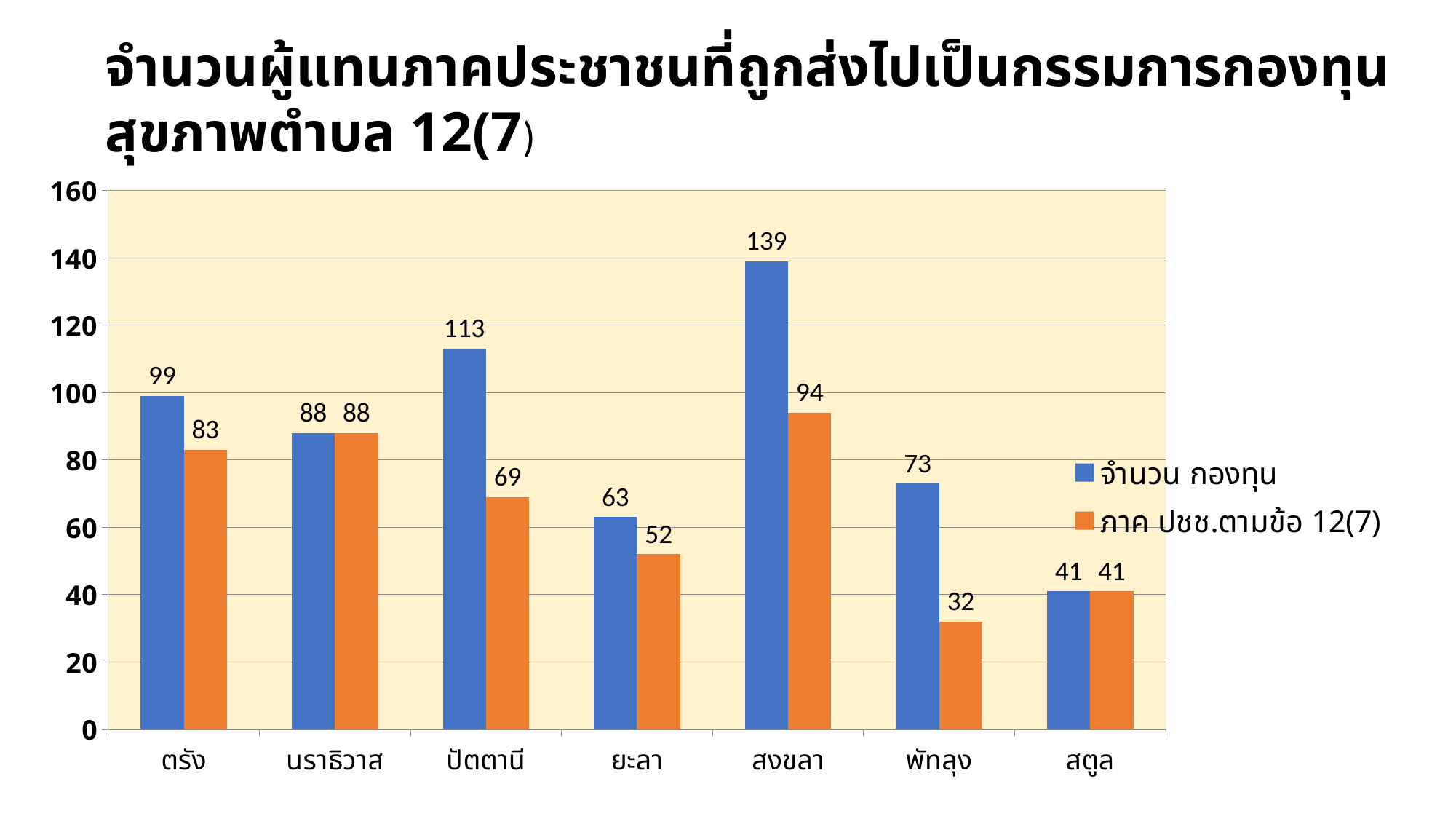
What is the value of จำนวน กองทุน for สงขลา? 139 What kind of chart is shown on the slide? bar chart Which is larger: จำนวน กองทุน for ตรัง or จำนวน กองทุน for นราธิวาส? ตรัง What is the difference between จำนวน กองทุน for ปัตตานี and จำนวน กองทุน for ยะลา? 50 How many series does the legend list? 2 Is the value of จำนวน กองทุน for พัทลุง greater or less than 80? less What is the value of ภาค ปชช.ตามข้อ 12(7) for พัทลุง? 32 What is the value of ภาค ปชช.ตามข้อ 12(7) for ปัตตานี? 69 How many provinces are shown on the x axis? 7 Which province has the highest value for จำนวน กองทุน? สงขลา Which province has the lowest value for ภาค ปชช.ตามข้อ 12(7)? พัทลุง What is the difference between จำนวน กองทุน and ภาค ปชช.ตามข้อ 12(7) for สงขลา? 45